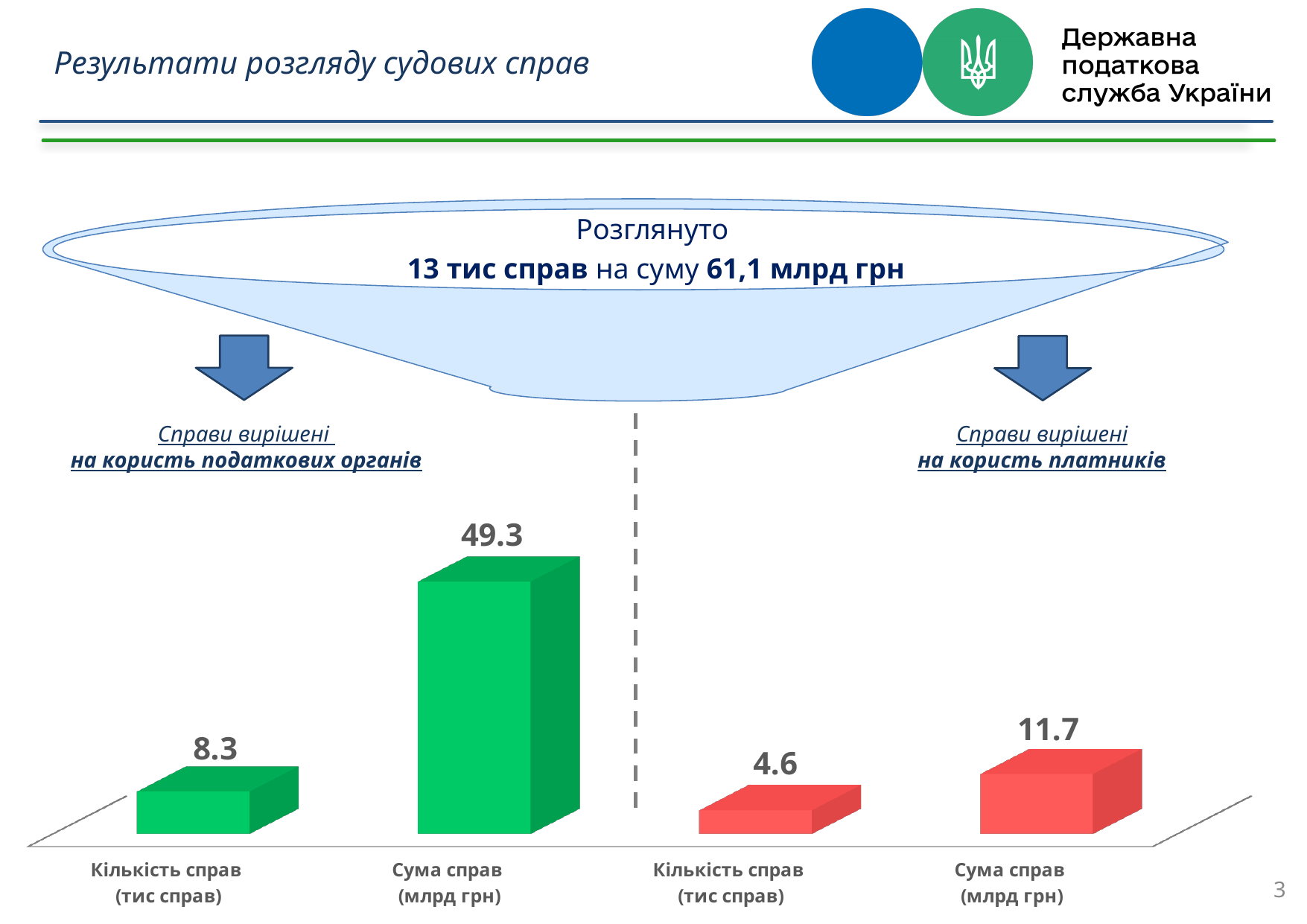
Which bar on the chart has the highest value? Сума справ (млрд грн) на користь податкових органів What is the value of the bar for 'Кількість справ (тис справ)' under 'Справи вирішені на користь платників'? 4.6 Which bar on the chart has the lowest value? Кількість справ (тис справ) на користь платників What is the value of the bar for 'Кількість справ (тис справ)' under 'Справи вирішені на користь податкових органів'? 8.3 What is the difference between the 'Сума справ' values for cases decided in favour of tax authorities and in favour of taxpayers? 37.6 What is the value of the bar for 'Сума справ (млрд грн)' under 'Справи вирішені на користь податкових органів'? 49.3 What type of chart is shown on the slide? Bar chart How many bars are plotted on the chart? 4 What is the difference between the 'Кількість справ' values for cases decided in favour of tax authorities and in favour of taxpayers? 3.7 What is the value of the bar for 'Сума справ (млрд грн)' under 'Справи вирішені на користь платників'? 11.7 What colour are the bars for cases decided in favour of taxpayers ('на користь платників')? Red Which is larger: the 'Кількість справ' value in favour of tax authorities or in favour of taxpayers? In favour of tax authorities (8.3)